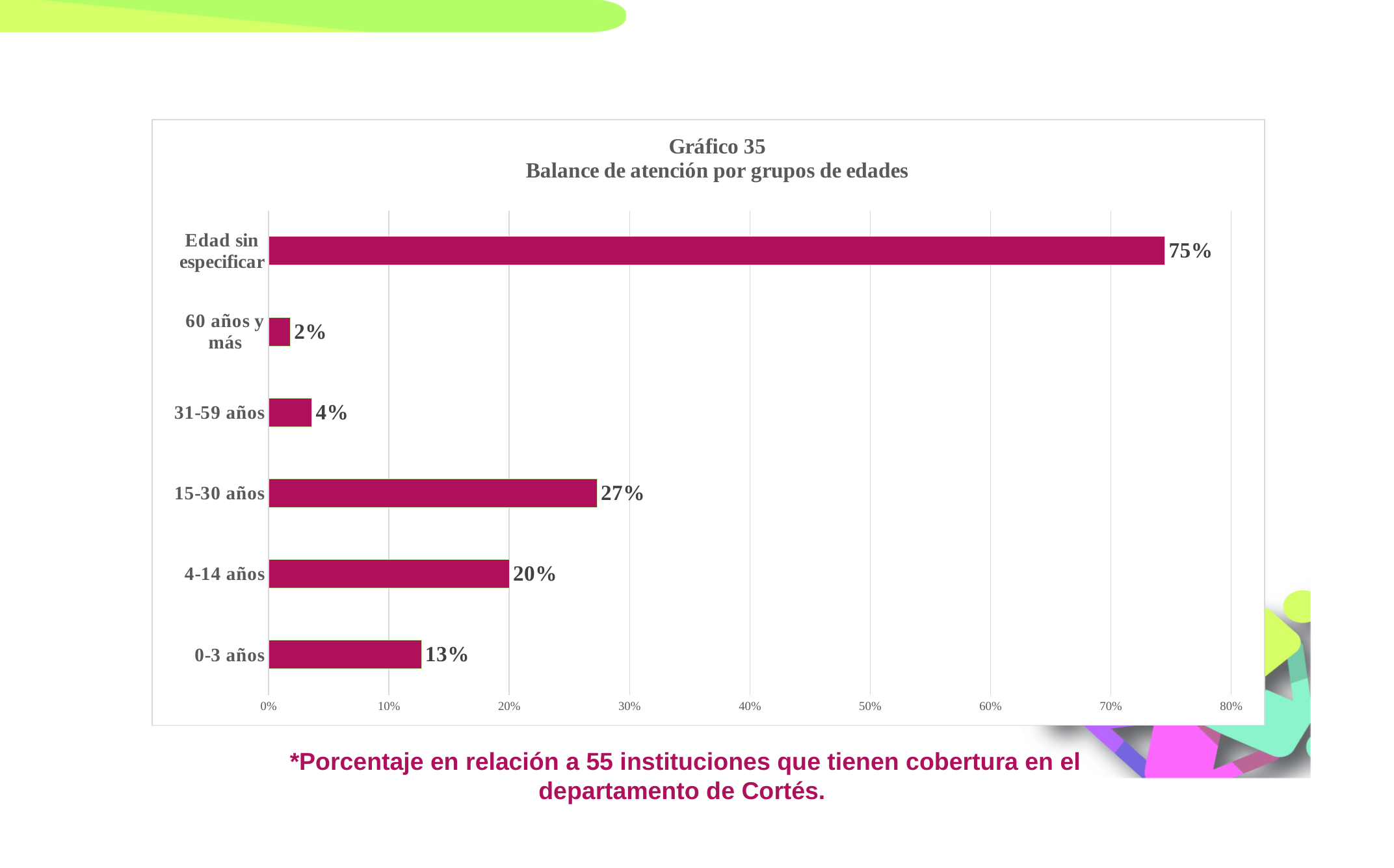
What is the value for '15-30 años'? 27% What kind of chart is shown on the slide? bar chart What is the value for '0-3 años'? 13% What is the value for 'Edad sin especificar'? 75% Which is larger, the value for '4-14 años' or the value for '0-3 años'? 4-14 años What is the value for '60 años y más'? 2% What is the difference between the values for '15-30 años' and '4-14 años'? 7% Which age group has the highest value? Edad sin especificar How many age groups are shown in the chart? 6 What is the title of the chart? Gráfico 35 Balance de atención por grupos de edades Is the value for 'Edad sin especificar' greater or less than 70%? greater Which age group has the lowest value? 60 años y más